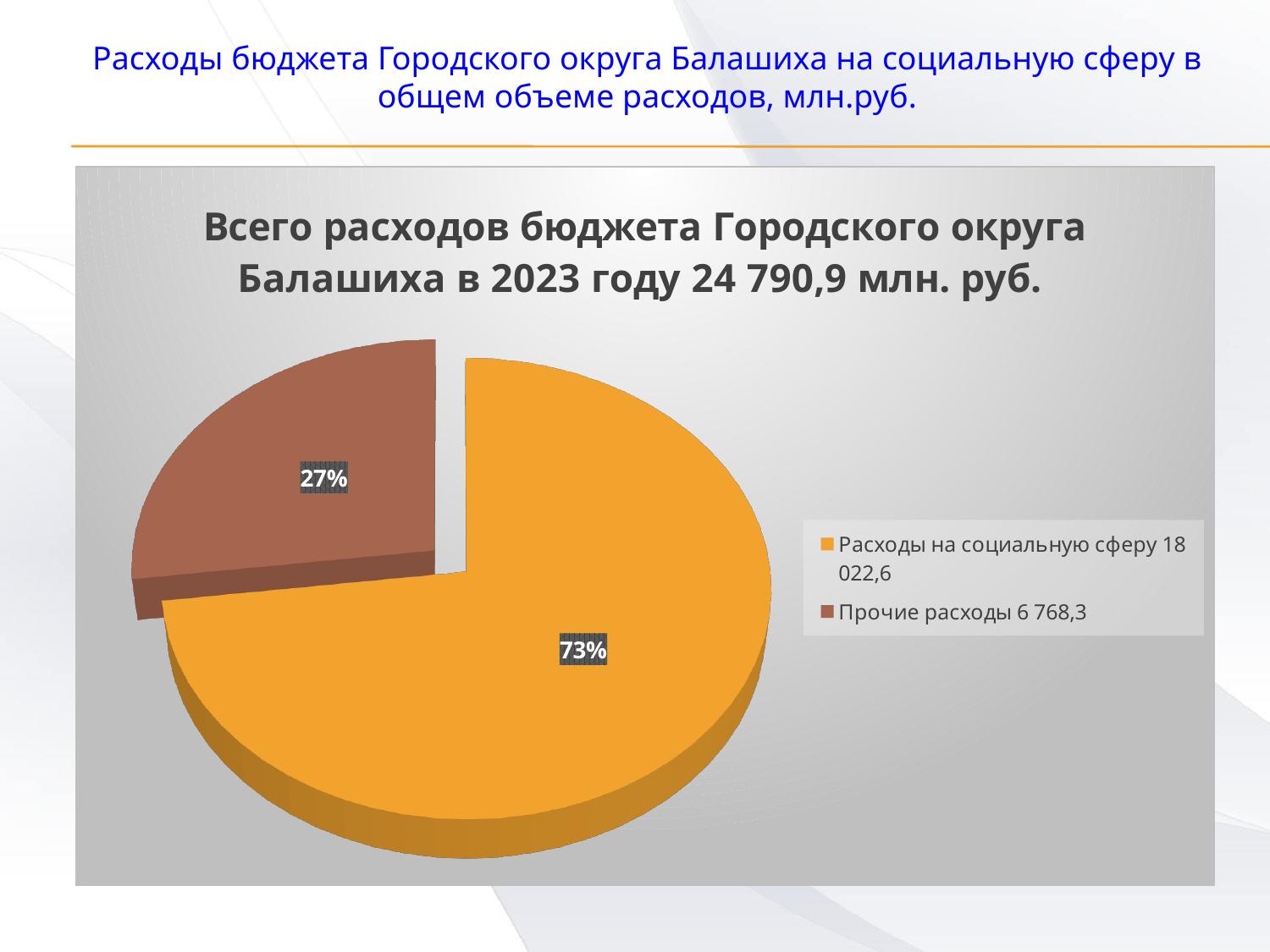
What value is given in the legend for "Расходы на социальную сферу"? 18 022,6 How many slices does the pie chart have? 2 Which slice is the smallest? Прочие расходы What is the difference in percentage points between the "Расходы на социальную сферу" slice and the "Прочие расходы" slice? 46 percentage points What kind of chart is shown on the slide? pie chart What value is given in the legend for "Прочие расходы"? 6 768,3 What total budget expenditure for 2023 is stated in the chart title? 24 790,9 млн. руб. What colour is the "Прочие расходы" slice? brown What share of the pie does "Прочие расходы" take? 27% Which slice is the largest? Расходы на социальную сферу Which is larger: the share for "Расходы на социальную сферу" or for "Прочие расходы"? Расходы на социальную сферу What share of the pie does "Расходы на социальную сферу" take? 73%